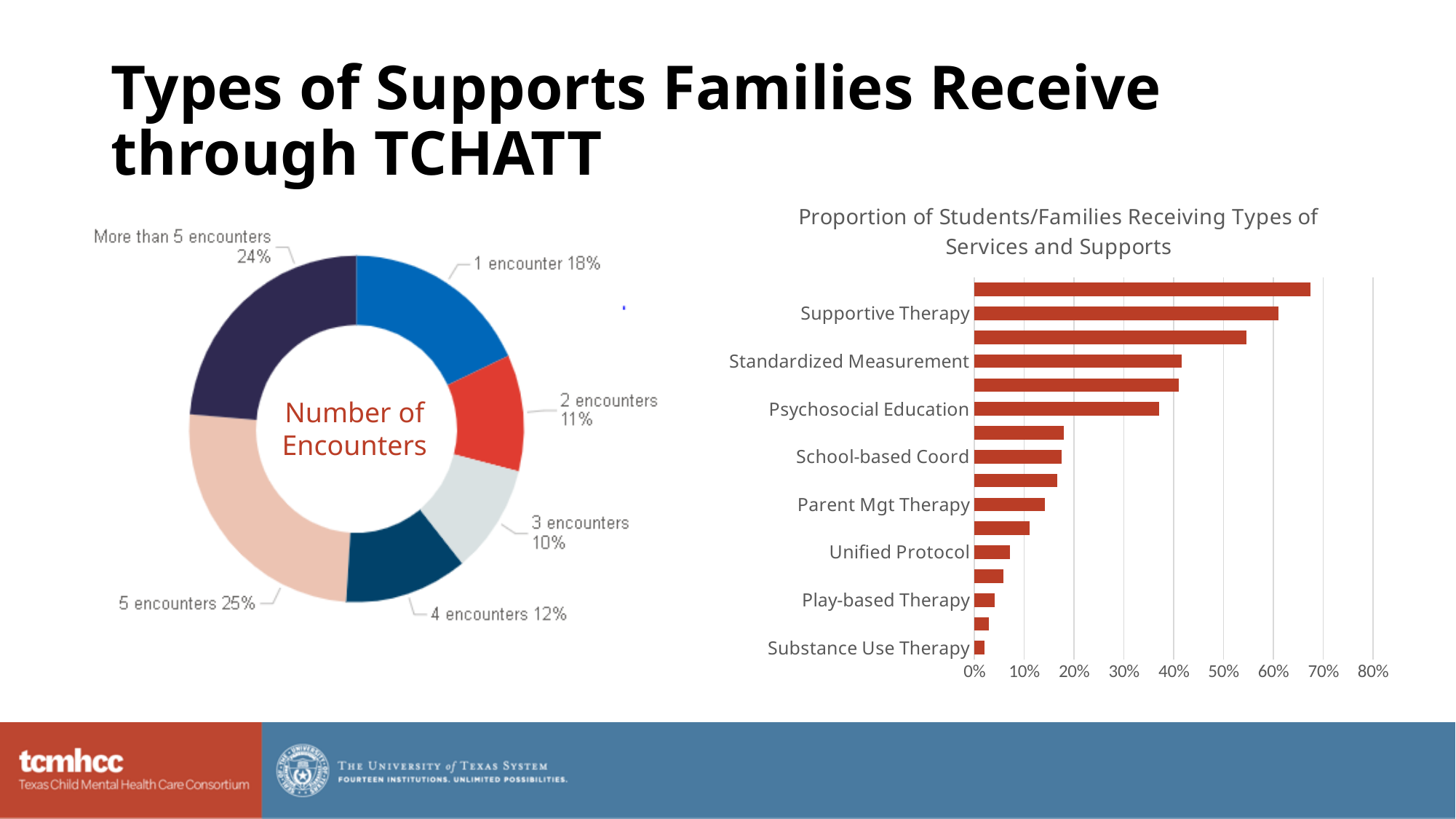
In the Proportion of Students/Families Receiving Types of Services and Supports chart, is the value for Supportive Therapy greater or less than 50%? greater In the Number of Encounters donut chart, what percentage of families had 5 encounters? 25% In the Proportion of Students/Families Receiving Types of Services and Supports chart, which is larger: Psychosocial Education or Parent Mgt Therapy? Psychosocial Education How many categories are shown in the Number of Encounters donut chart? 6 In the Number of Encounters donut chart, which category has the largest share? 5 encounters In the Number of Encounters donut chart, what is the difference between the share for 1 encounter and the share for 2 encounters? 7% What kind of chart is the Number of Encounters chart on the left? Donut (pie) chart What kind of chart is the Proportion of Students/Families Receiving Types of Services and Supports chart on the right? Bar chart In the Proportion of Students/Families Receiving Types of Services and Supports chart, is the value for Substance Use Therapy greater or less than 10%? less In the Number of Encounters donut chart, which category has the smallest share? 3 encounters What text is written in the centre of the donut chart on the left? Number of Encounters In the Number of Encounters donut chart, what percentage of families had 3 encounters? 10%